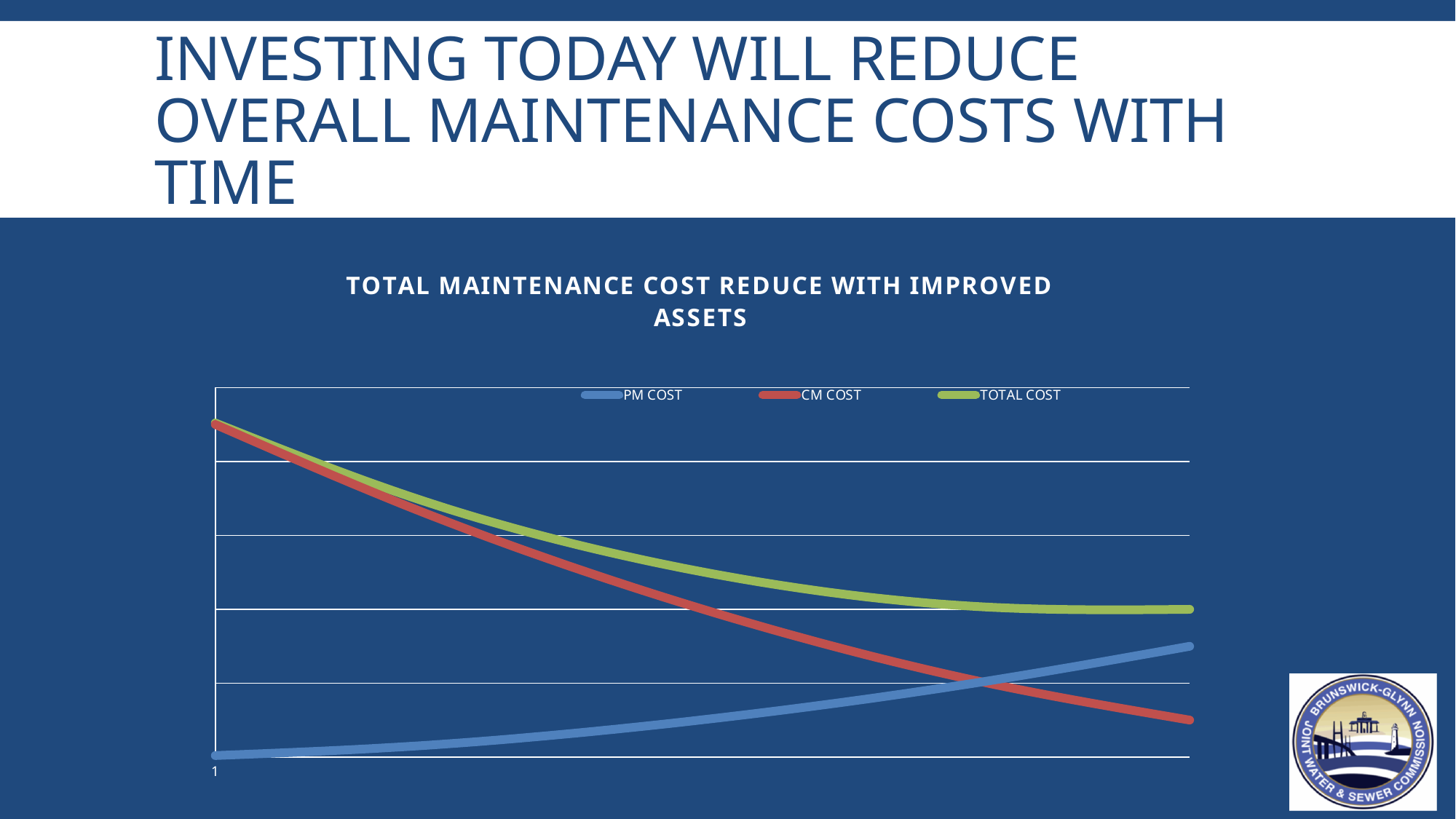
At the left end of the chart, which is higher: CM COST or PM COST? CM COST What kind of chart is shown on the slide? line chart Which series is drawn in red? CM COST Which series is the lowest at the left end of the chart? PM COST Which series is the lowest at the right end of the chart? CM COST At the right end of the chart, which is higher: PM COST or CM COST? PM COST Does the TOTAL COST line rise or fall from left to right? falls At the right end of the chart, which is higher: TOTAL COST or PM COST? TOTAL COST Does the PM COST line rise or fall from left to right? rises Does the CM COST line rise or fall from left to right? falls What is the title of the chart? TOTAL MAINTENANCE COST REDUCE WITH IMPROVED ASSETS How many series does the chart's legend list? 3